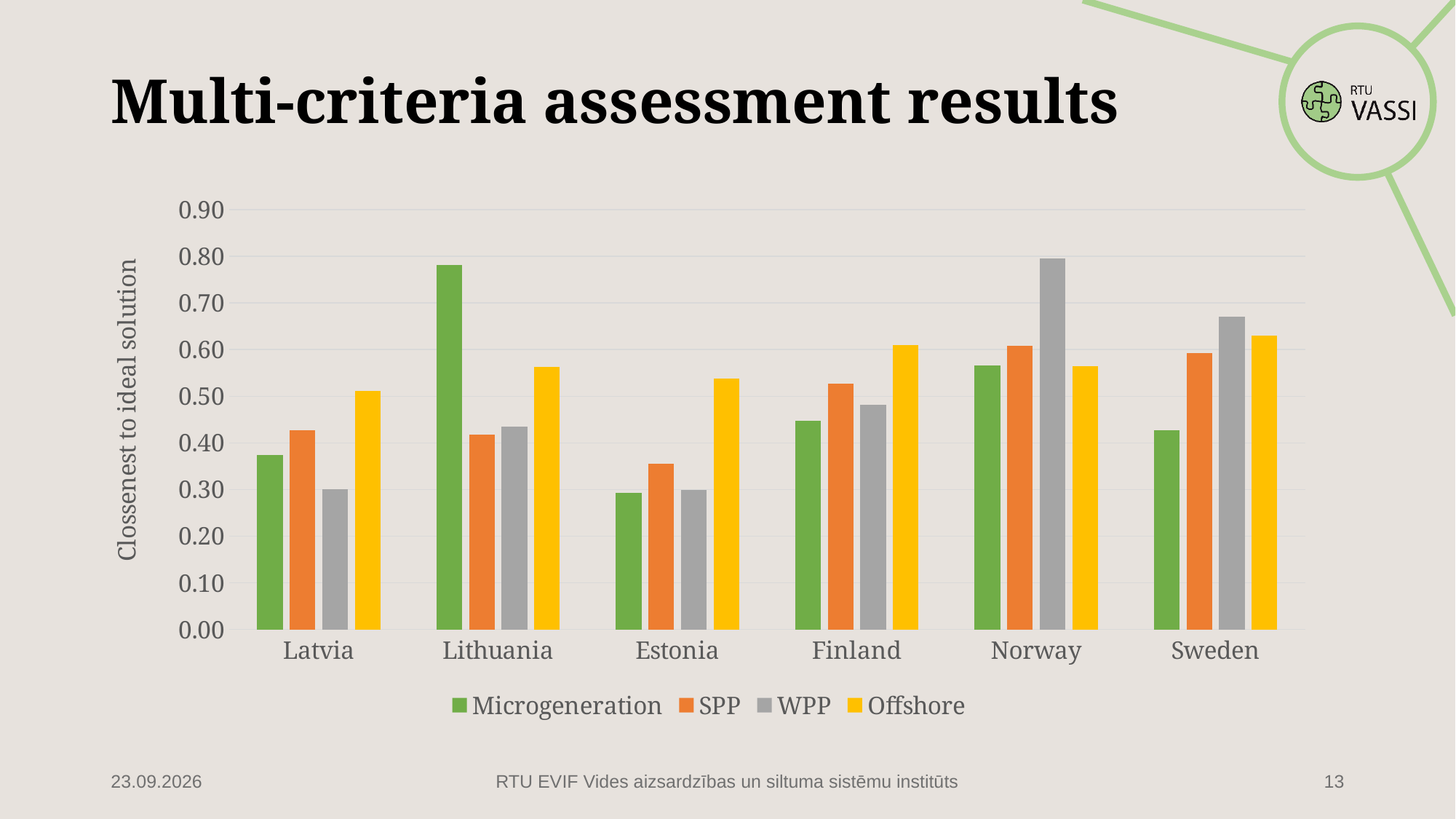
Is the WPP value for Estonia greater or less than 0.40? less Which country has the highest Microgeneration value? Lithuania What is the title of the chart's vertical axis? Clossenest to ideal solution What kind of chart is shown on the slide? bar chart Which country has the highest WPP value? Norway Is the Microgeneration value for Lithuania greater or less than 0.70? greater Which country has the lowest Offshore value? Latvia Which is larger for Sweden, the WPP value or the Microgeneration value? WPP How many countries are shown on the x axis of the chart? 6 How many series does the legend list? 4 Which series is shown in yellow in the legend? Offshore Which country has the lowest Microgeneration value? Estonia